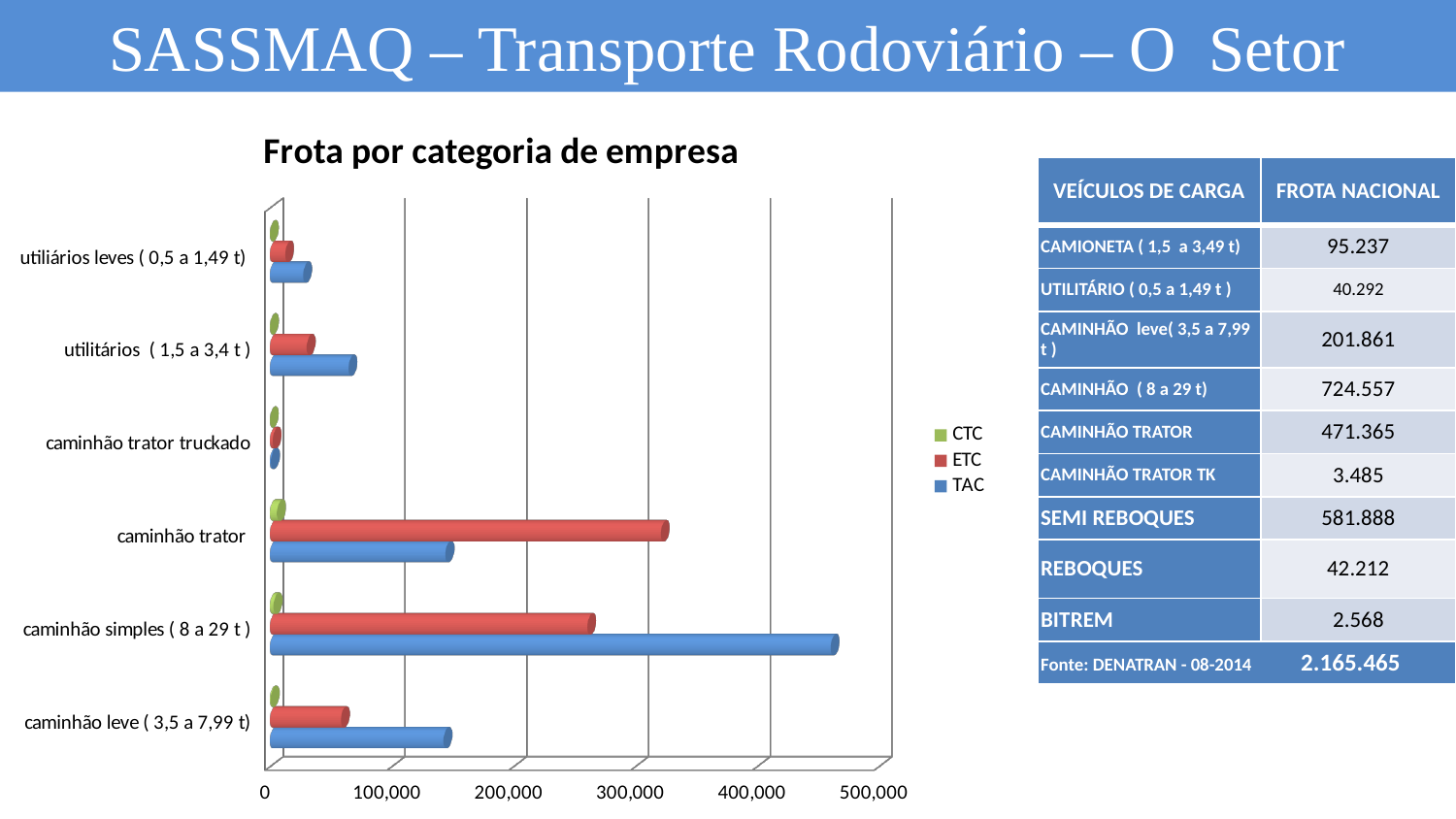
Is the TAC value for caminhão simples ( 8 a 29 t ) greater or less than 400,000? greater How many series does the chart legend list? 3 How many categories are plotted on the chart? 6 Which category has the highest ETC value? caminhão trator What kind of chart is shown on the slide? bar chart What is the title of the chart? Frota por categoria de empresa Is the ETC value for caminhão trator greater or less than 300,000? greater Is the ETC value for caminhão simples ( 8 a 29 t ) greater or less than 300,000? less Which category has the lowest TAC value? caminhão trator truckado Which category has the highest TAC value? caminhão simples ( 8 a 29 t ) For caminhão trator, which series has the larger value, ETC or TAC? ETC